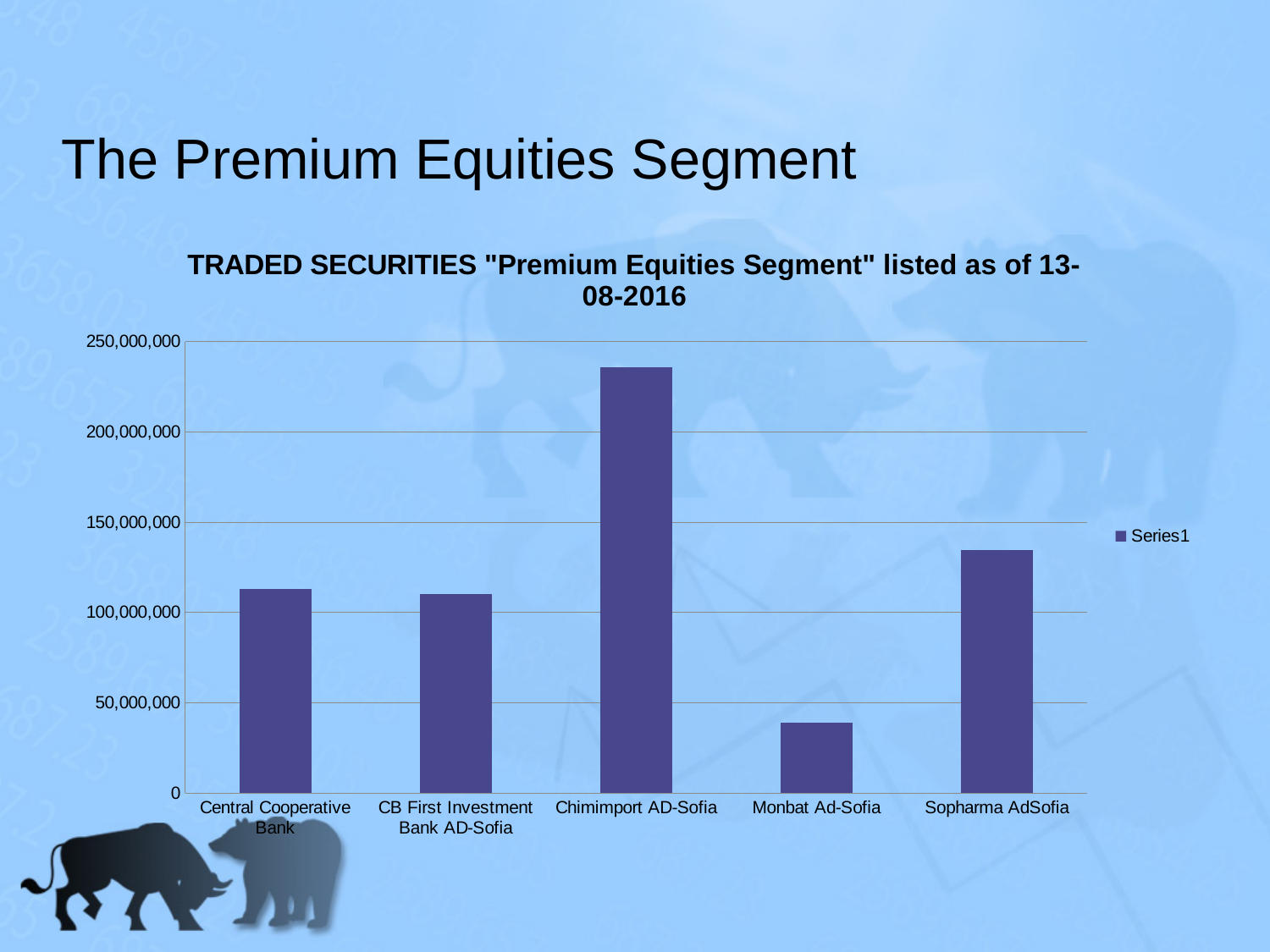
Which company has the lowest value in the chart? Monbat Ad-Sofia Is the value for Monbat Ad-Sofia greater or less than 50,000,000? less What kind of chart is shown on the slide? bar chart Is the value for Sopharma AdSofia greater or less than 150,000,000? less Is the value for Chimimport AD-Sofia greater or less than 200,000,000? greater How many series does the chart's legend list? 1 What is the name of the series shown in the chart's legend? Series1 Which is larger, the value for Sopharma AdSofia or the value for Central Cooperative Bank? Sopharma AdSofia Which company has the highest value in the chart? Chimimport AD-Sofia What is the title of the chart? TRADED SECURITIES "Premium Equities Segment" listed as of 13-08-2016 How many companies are shown on the x axis of the chart? 5